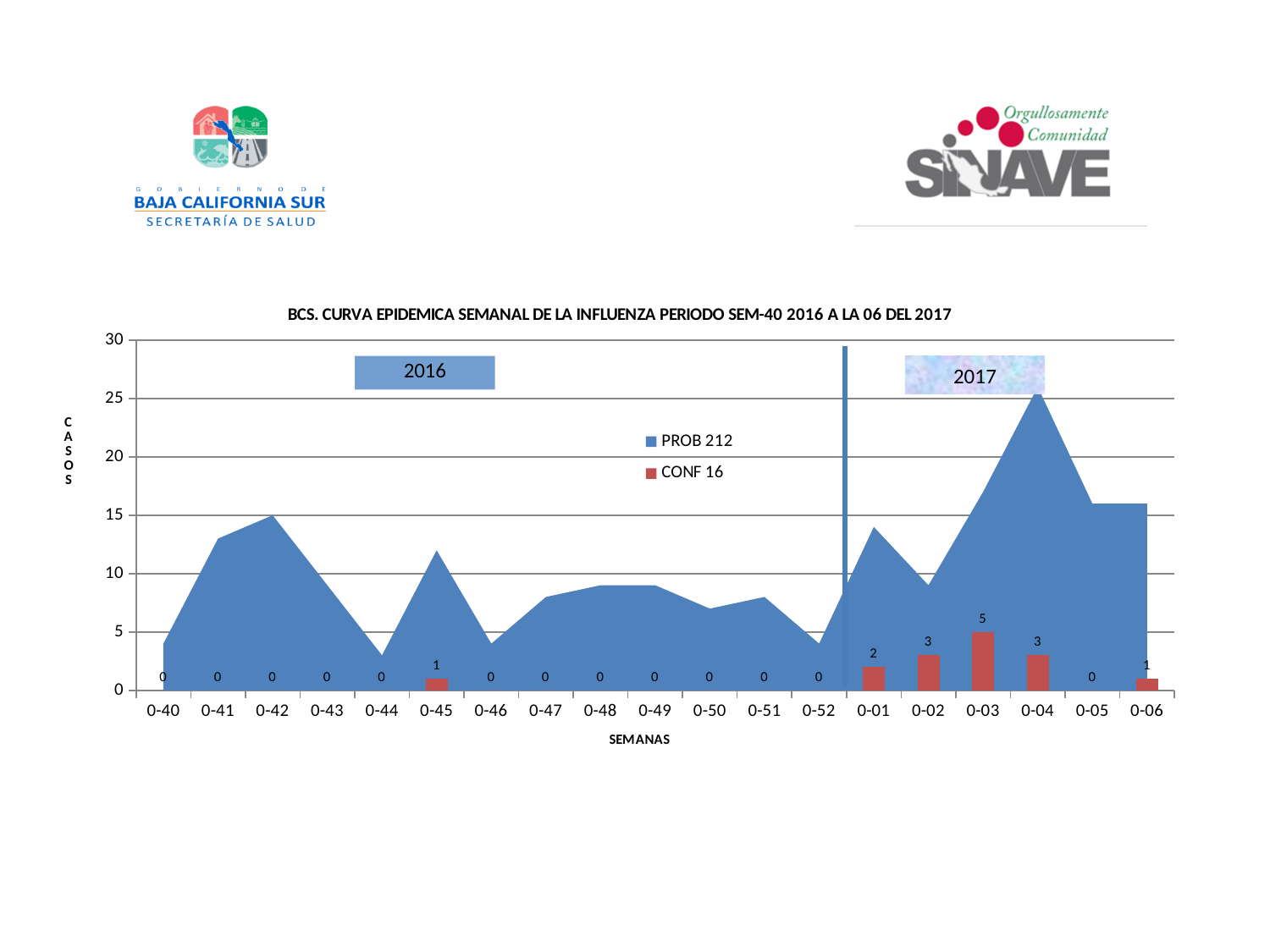
Is the PROB value for week 0-42 greater or less than 10? greater How many series does the legend list? 2 How many weeks are shown on the x axis? 19 Which week has the larger CONF value, 0-01 or 0-03? 0-03 Which week has the highest CONF value? 0-03 What is the difference between the CONF values for weeks 0-03 and 0-02? 2 What is the CONF value for week 0-03? 5 Is the PROB value for week 0-44 greater or less than 5? less Do the PROB values rise or fall from week 0-01 to week 0-04? rise What is the CONF value for week 0-45? 1 What is the CONF value for week 0-01? 2 Is the PROB value for week 0-04 greater or less than 20? greater